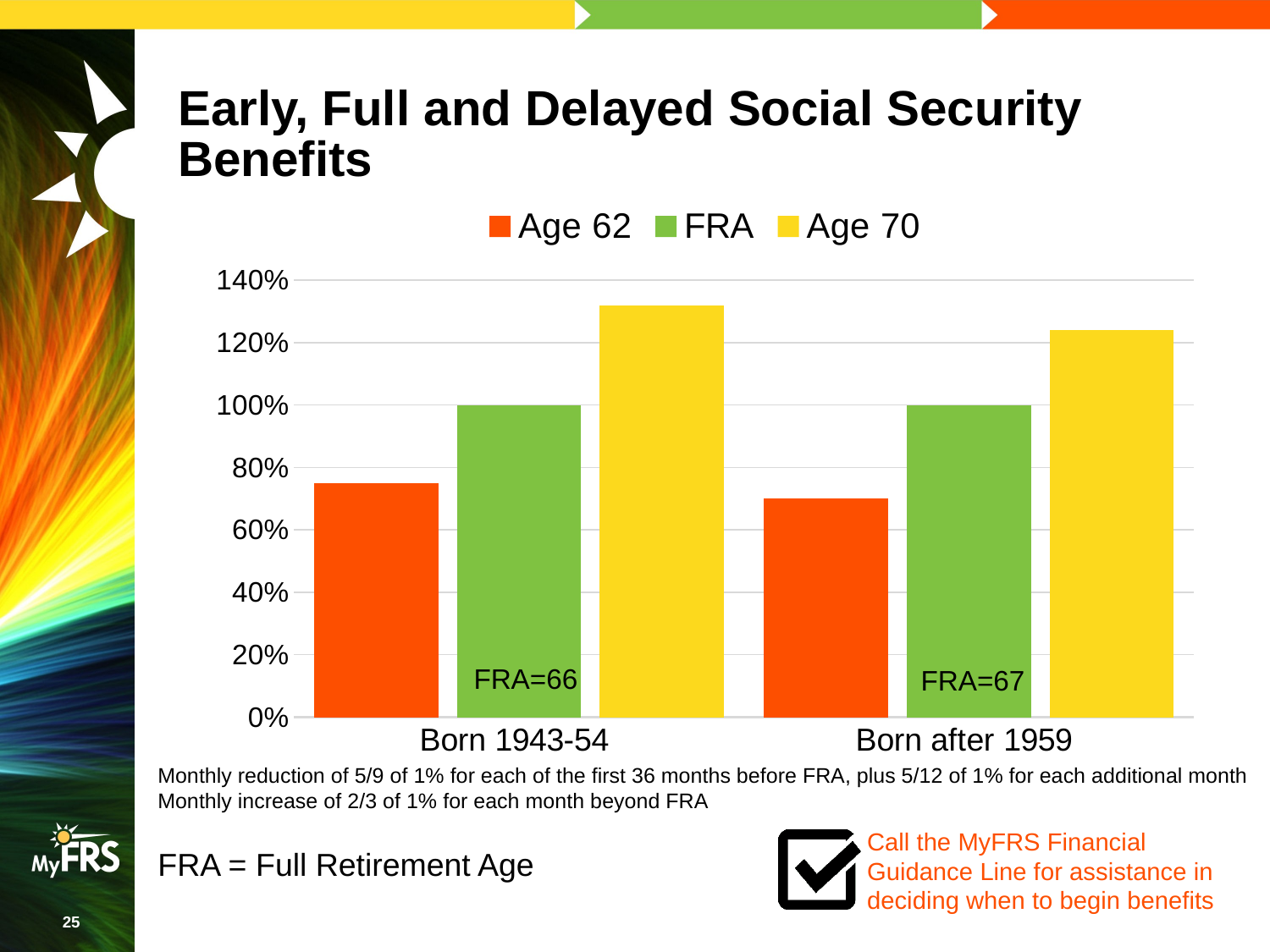
Is the Age 62 value for Born 1943-54 greater or less than 80%? less What is the value of the FRA bar for Born 1943-54? 100% Is the Age 70 value for Born after 1959 greater or less than 120%? greater What is the value of the FRA bar for Born after 1959? 100% What label is printed on the FRA bar for Born after 1959? FRA=67 What colour represents the Age 70 series in the legend? yellow How many categories are shown on the x axis? 2 How many series does the legend list? 3 Which series has the lowest bar for Born after 1959? Age 62 What kind of chart is shown on the slide? bar chart Which is larger: the Age 70 value for Born 1943-54 or the Age 70 value for Born after 1959? Born 1943-54 Which series has the highest bar for Born 1943-54? Age 70